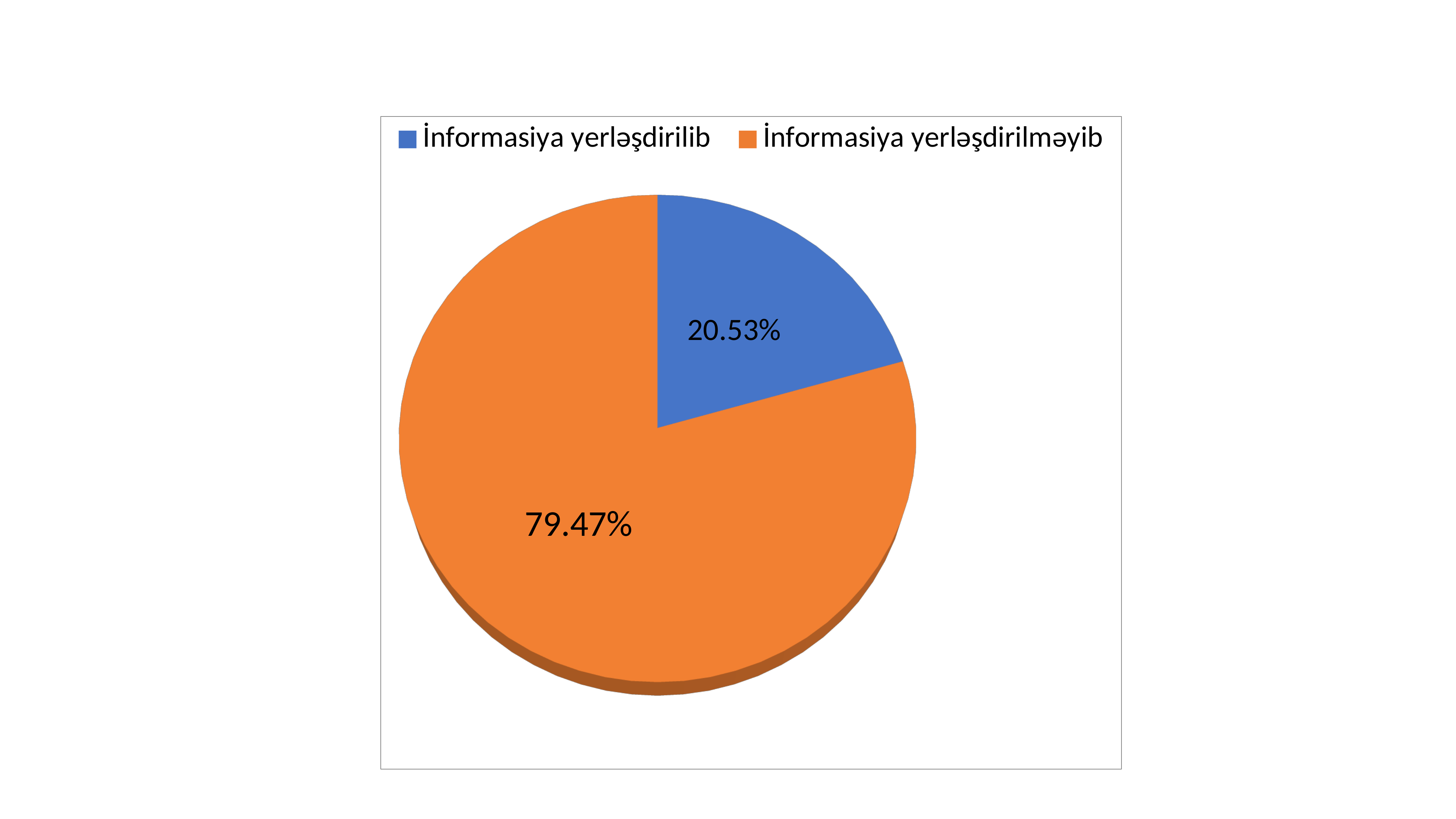
Which is larger: the "İnformasiya yerləşdirilib" slice or the "İnformasiya yerləşdirilməyib" slice? İnformasiya yerləşdirilməyib Which slice is the smallest? İnformasiya yerləşdirilib What share of the pie does "İnformasiya yerləşdirilməyib" represent? 79.47% What kind of chart is shown on the slide? Pie chart Which slice is the largest? İnformasiya yerləşdirilməyib What is the difference in percentage points between the "İnformasiya yerləşdirilməyib" slice and the "İnformasiya yerləşdirilib" slice? 58.94 How many entries does the legend list? 2 What colour is the "İnformasiya yerləşdirilməyib" slice? Orange What share of the pie does "İnformasiya yerləşdirilib" represent? 20.53% How many slices does the pie chart have? 2 What colour is the "İnformasiya yerləşdirilib" slice? Blue